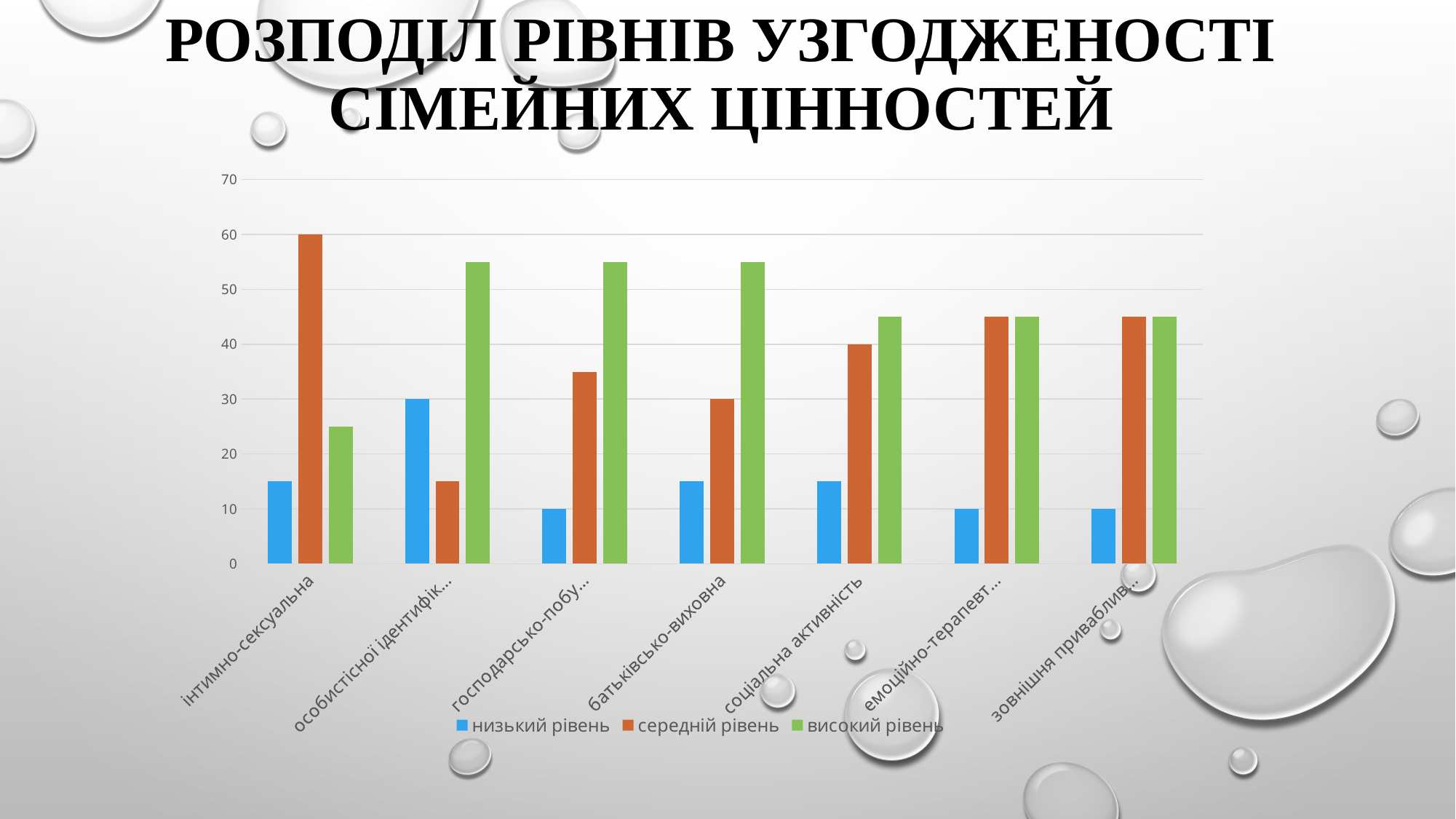
Which category has the lowest value for високий рівень? інтимно-сексуальна How many series does the legend list? 3 Is the value of низький рівень for інтимно-сексуальна greater or less than 20? less How many categories are shown along the x axis? 7 What is the value of середній рівень for інтимно-сексуальна? 60 Which category has the highest value for середній рівень? інтимно-сексуальна What is the value of середній рівень for батьківсько-виховна? 30 What is the value of середній рівень for соціальна активність? 40 What kind of chart is shown on the slide? bar chart For інтимно-сексуальна, which is larger: середній рівень or високий рівень? середній рівень What colour represents високий рівень in the legend? green Is the value of високий рівень for батьківсько-виховна greater or less than 50? greater